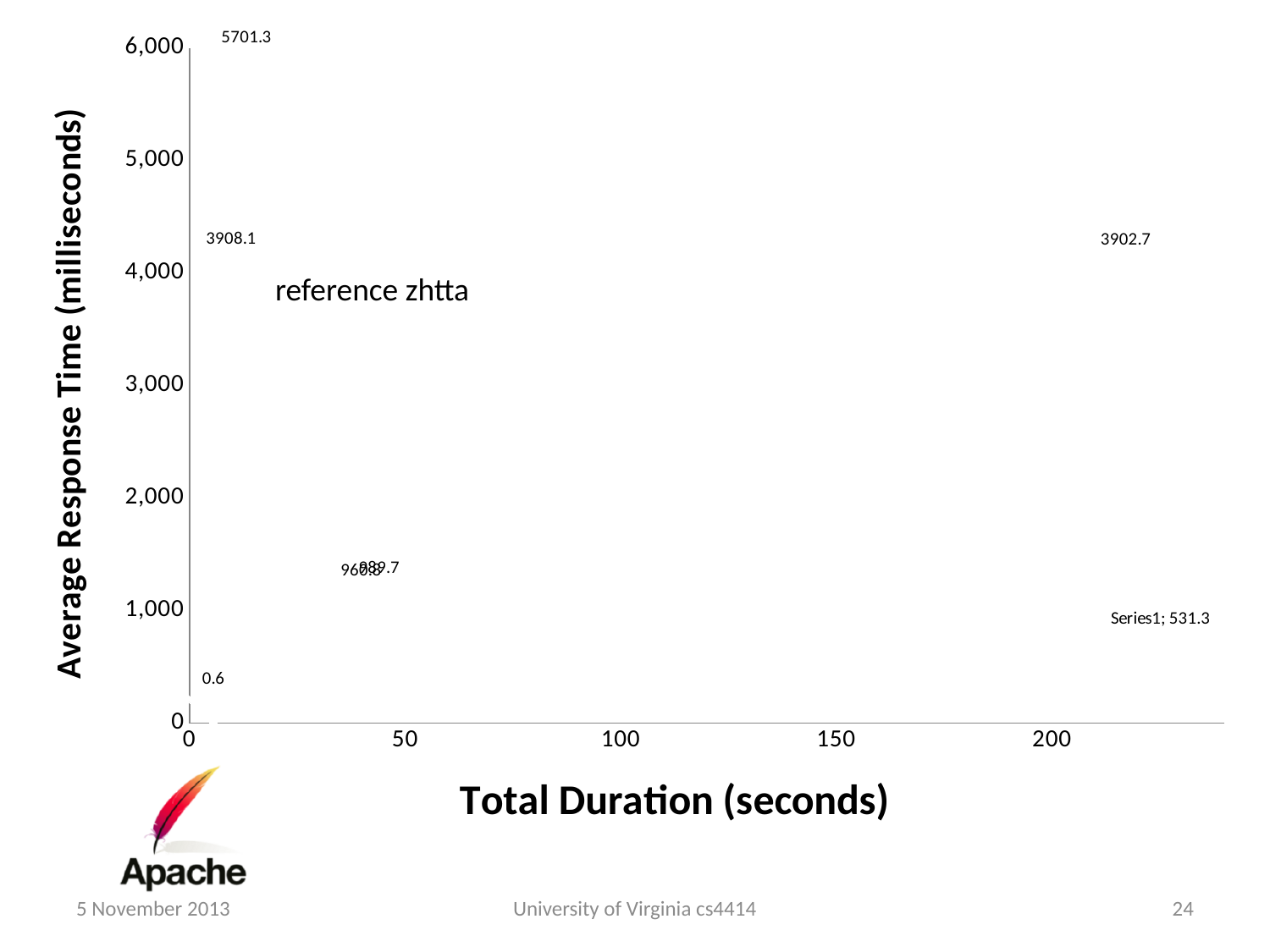
What value is shown in the data label that includes the text 'Series1'? 531.3 Is the data label value 5701.3 greater or less than 5,000 on the vertical axis? greater What is the difference between the data labels 3908.1 and 3902.7? 5.4 Is the data label value 531.3 greater or less than 1,000 on the vertical axis? less What is the largest tick value shown on the horizontal axis? 200 What kind of chart is shown on the slide? scatter chart What text annotation appears near the point labeled 3908.1? reference zhtta What is the lowest data label value shown on the chart? 0.6 Which is larger, the data label 3908.1 or the data label 3902.7? 3908.1 What is the difference between the data labels 5701.3 and 3908.1? 1793.2 What is the highest data label value shown on the chart? 5701.3 What is the title of the vertical axis? Average Response Time (milliseconds)